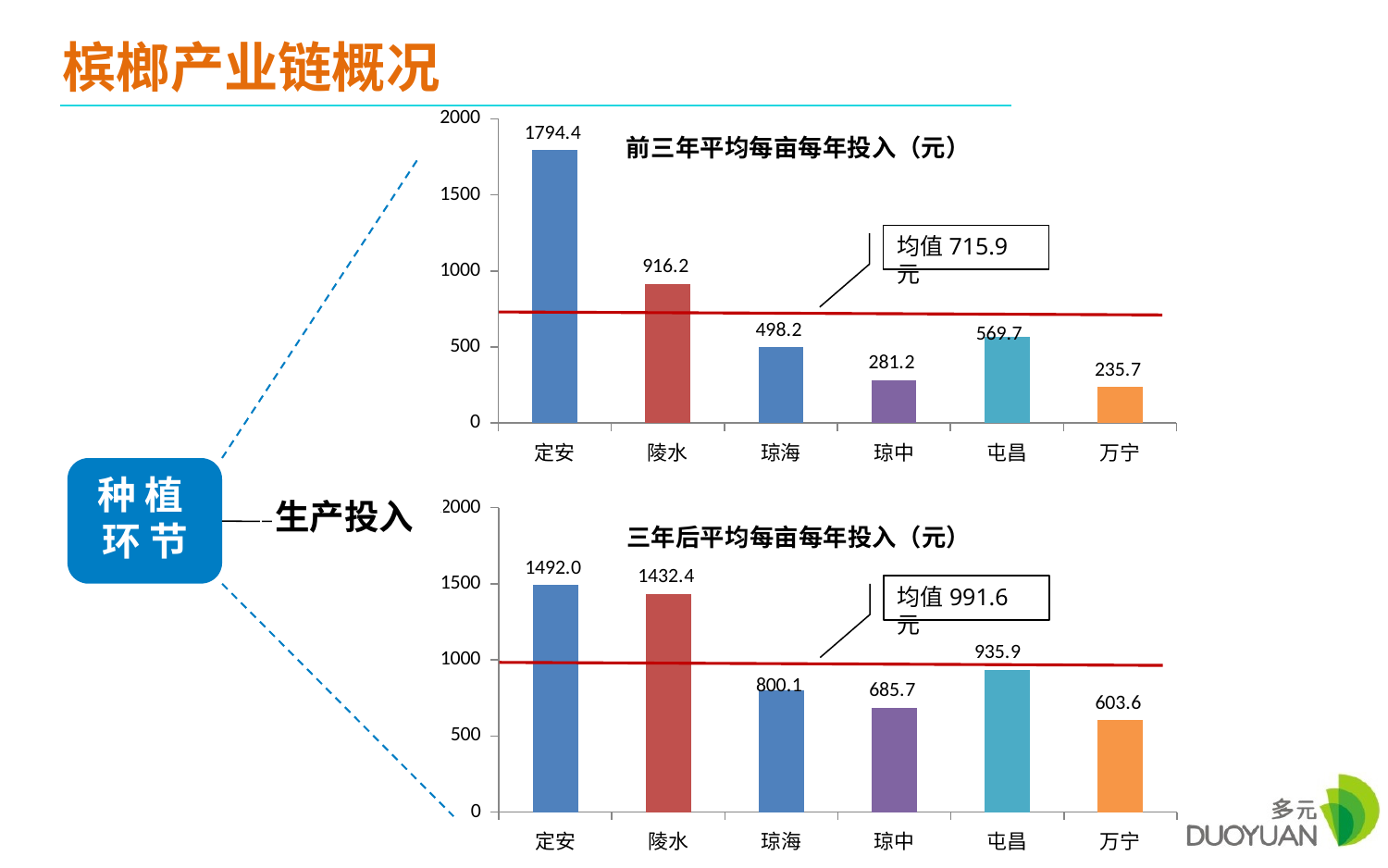
In the chart titled 三年后平均每亩每年投入（元）, what is the difference between the values for 定安 and 陵水? 59.6 In the chart titled 前三年平均每亩每年投入（元）, which category has the lowest value? 万宁 In the chart titled 前三年平均每亩每年投入（元）, what is the difference between the values for 陵水 and 琼海? 418.0 In the chart titled 前三年平均每亩每年投入（元）, is the value for 屯昌 greater or less than 500? greater In the chart titled 前三年平均每亩每年投入（元）, what is the value for 定安? 1794.4 In the chart titled 三年后平均每亩每年投入（元）, what is the value for 屯昌? 935.9 In the chart titled 三年后平均每亩每年投入（元）, which is larger, the value for 琼海 or the value for 琼中? 琼海 How many categories are shown in the chart titled 三年后平均每亩每年投入（元）? 6 What type of chart is the chart titled 前三年平均每亩每年投入（元）? bar chart In the chart titled 三年后平均每亩每年投入（元）, which category has the highest value? 定安 In the chart titled 三年后平均每亩每年投入（元）, what mean value (均值) is shown in the annotation? 991.6 元 In the chart titled 前三年平均每亩每年投入（元）, what mean value (均值) is shown in the annotation? 715.9 元